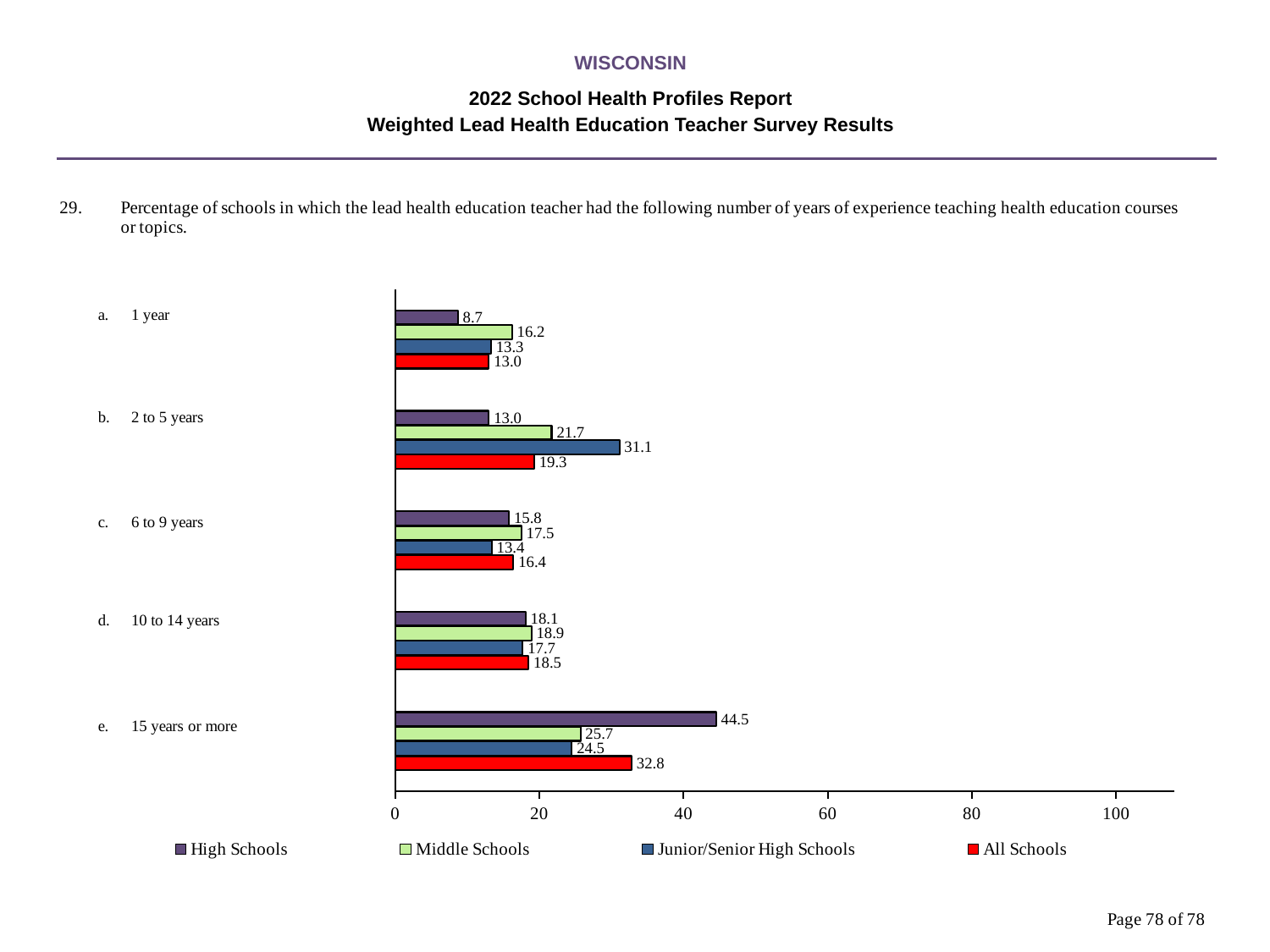
How many series does the legend list? 4 In the '2 to 5 years' category, which is larger: the Middle Schools value or the Junior/Senior High Schools value? Junior/Senior High Schools What is the difference between the High Schools and All Schools values in the '15 years or more' category? 11.7 What is the value for High Schools in the '15 years or more' category? 44.5 Which category has the highest value for Middle Schools? 15 years or more How many categories of years of experience are shown on the chart? 5 What colour represents All Schools in the chart? Red What kind of chart is shown on the slide? Bar chart What is the value for Junior/Senior High Schools in the '2 to 5 years' category? 31.1 What is the value for All Schools in the '1 year' category? 13.0 Is the value for High Schools in the '15 years or more' category greater or less than 40? greater Which category has the lowest value for High Schools? 1 year